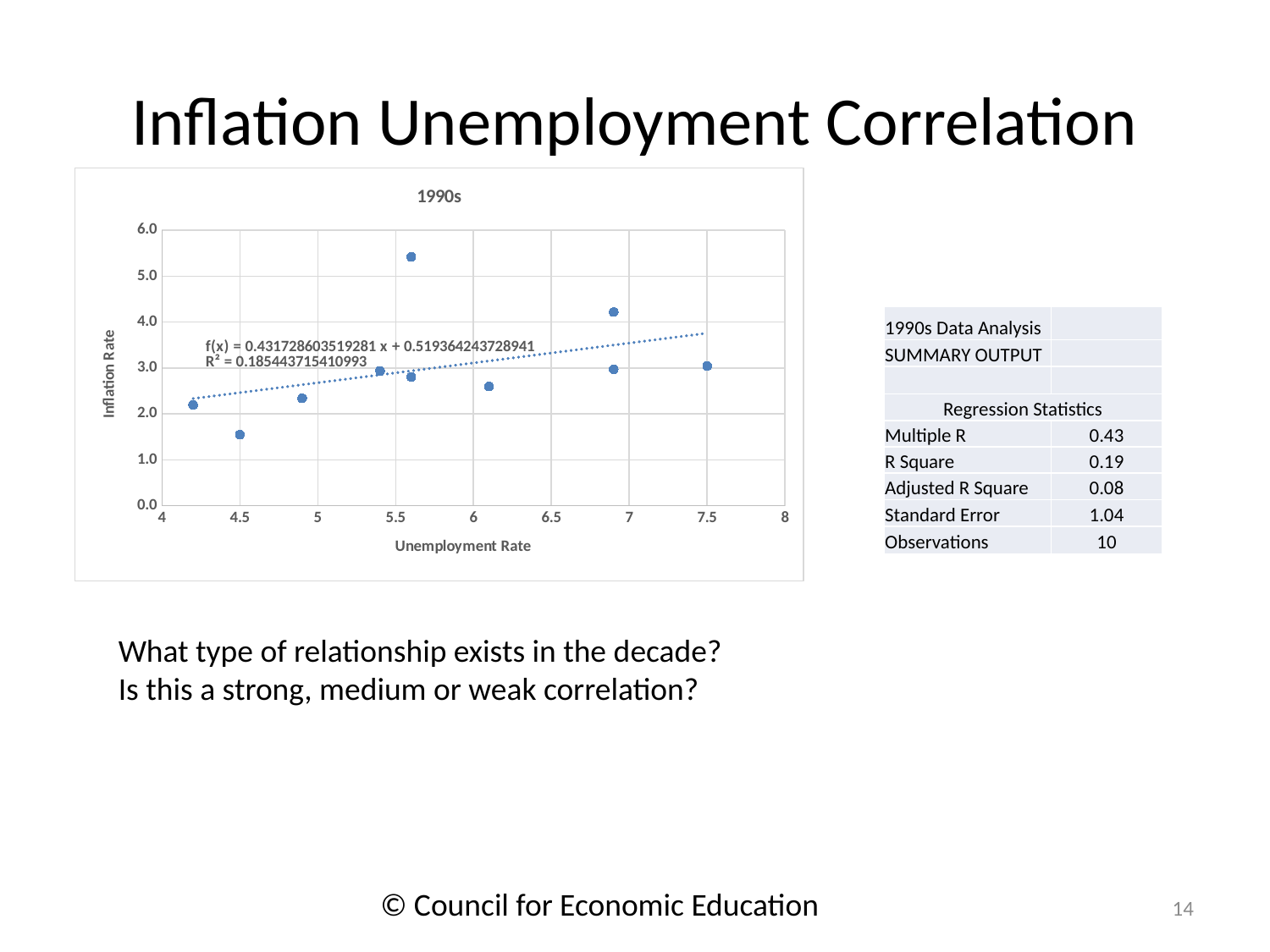
Is the unemployment rate of the leftmost point in the 1990s chart greater or less than 4.5? less What kind of chart is shown on the slide? scatter chart Does the dotted trendline in the 1990s chart rise or fall as the unemployment rate increases? rise How many data points are plotted in the 1990s chart? 10 Is the lowest inflation rate plotted in the 1990s chart greater or less than 2.0? less Is the unemployment rate of the rightmost point in the 1990s chart greater or less than 7? greater What is the title of the chart? 1990s What R² value is printed on the chart for the trendline? 0.185443715410993